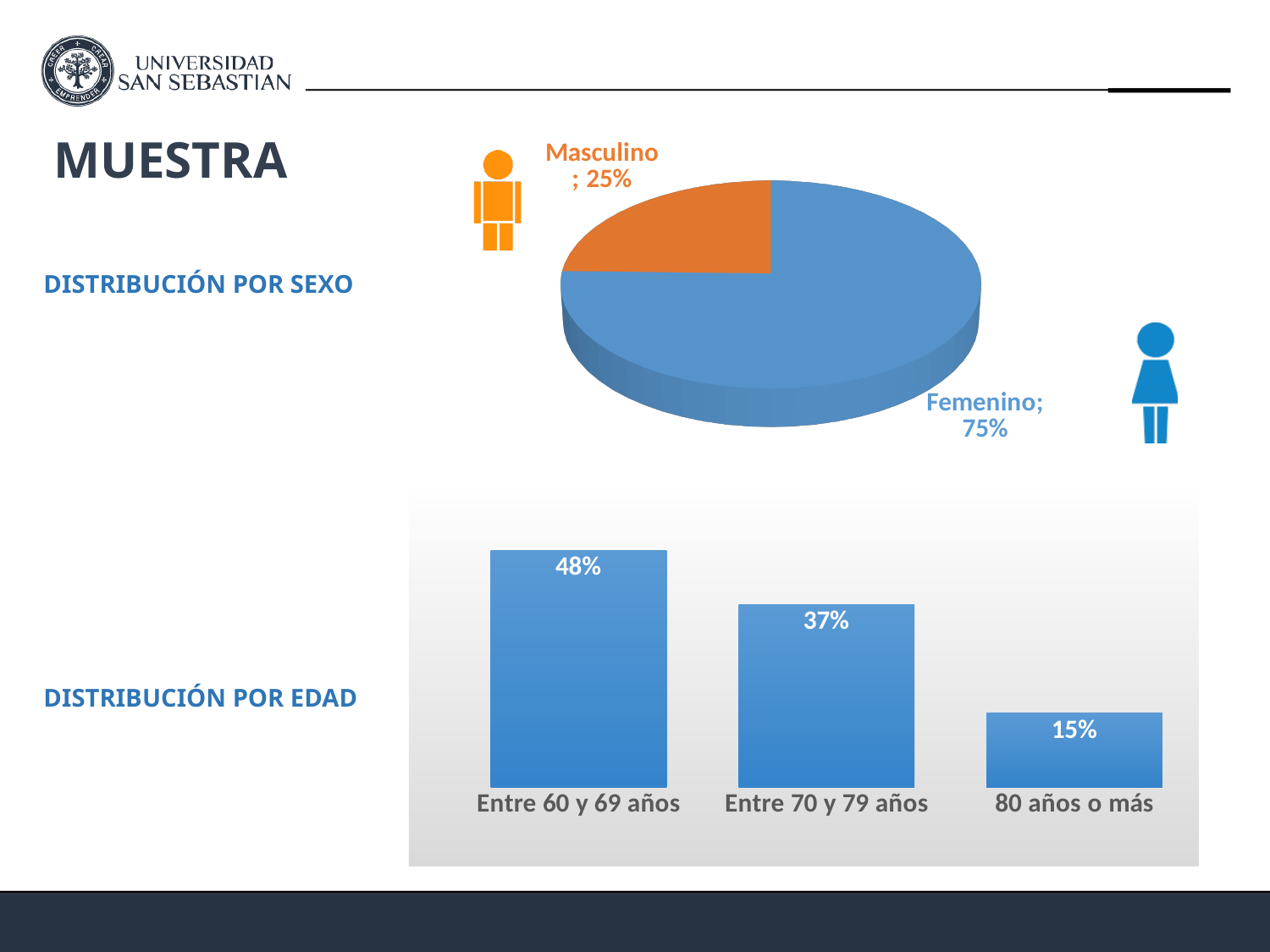
In the 'Distribución por sexo' pie chart, what percentage is Femenino? 75% In the 'Distribución por edad' chart, do the values rise or fall from left to right? Fall In the 'Distribución por edad' chart, what is the value for '80 años o más'? 15% In the 'Distribución por sexo' pie chart, how many slices are there? 2 What kind of chart is the 'Distribución por edad' chart? Bar chart In the 'Distribución por edad' chart, which age group has the lowest value? 80 años o más In the 'Distribución por edad' chart, what is the value for 'Entre 60 y 69 años'? 48% In the 'Distribución por sexo' pie chart, which category has the largest share? Femenino In the 'Distribución por sexo' pie chart, what percentage is Masculino? 25% In the 'Distribución por edad' chart, what is the difference between 'Entre 60 y 69 años' and 'Entre 70 y 79 años'? 11% In the 'Distribución por sexo' pie chart, what is the difference between the Femenino and Masculino shares? 50% What kind of chart is the 'Distribución por sexo' chart? Pie chart